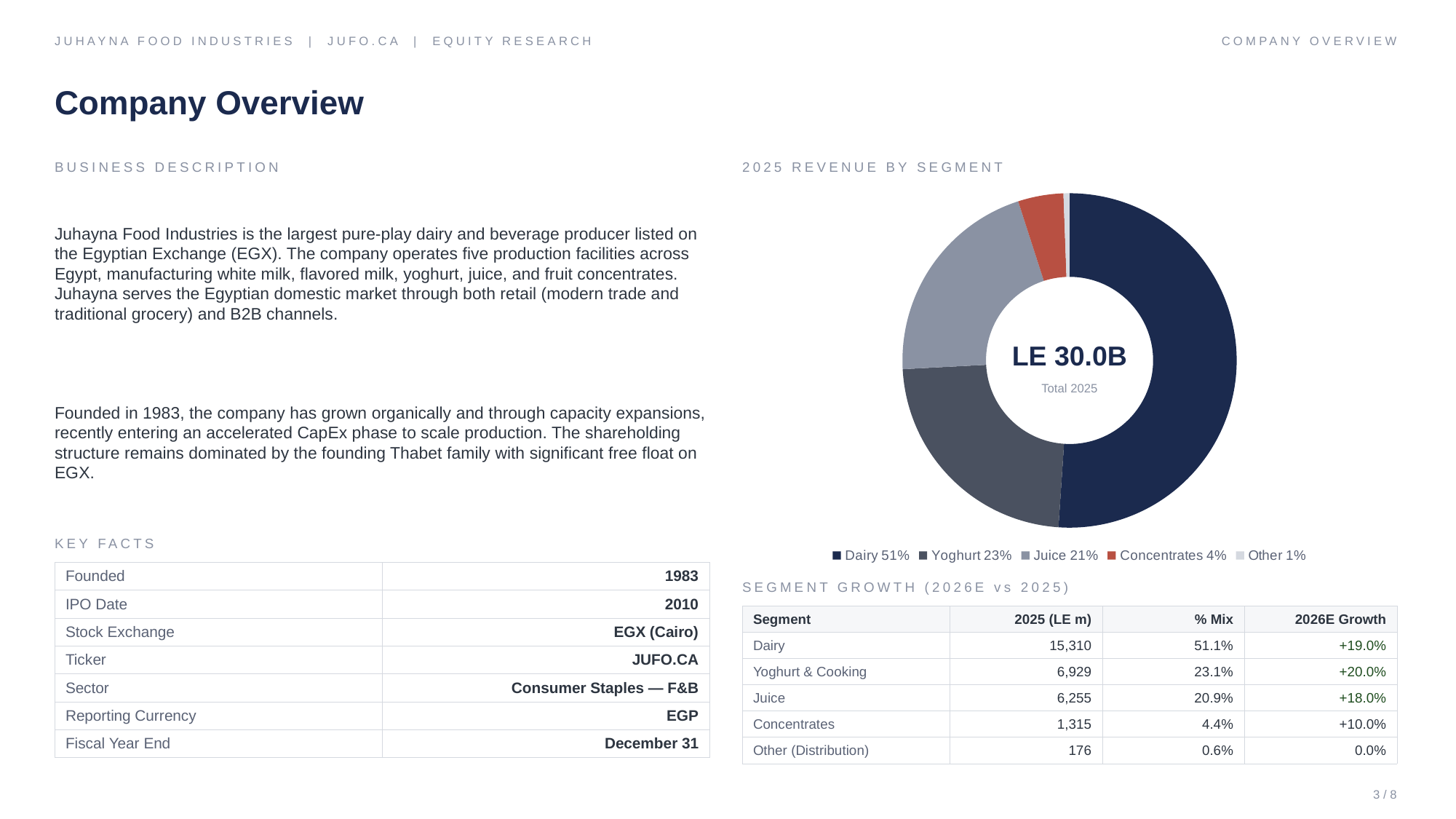
In the 2025 revenue by segment chart, which has a larger share: Yoghurt or Juice? Yoghurt How many segments are shown in the 2025 revenue by segment pie chart? 5 In the 2025 revenue by segment chart, what is the difference in percentage points between the Juice and Concentrates shares? 17 percentage points What share of 2025 revenue does the Concentrates segment represent in the pie chart? 4% What kind of chart is used to show 2025 revenue by segment? Pie chart (donut) What share of 2025 revenue does the Dairy segment represent in the pie chart? 51% What is the title of the pie chart on the slide? 2025 Revenue by Segment In the 2025 revenue by segment chart, what is the difference in percentage points between the Dairy and Yoghurt shares? 28 percentage points What share of 2025 revenue does the Juice segment represent in the pie chart? 21% Which segment has the smallest slice in the 2025 revenue by segment chart? Other What total value is printed in the centre of the 2025 revenue by segment donut chart? LE 30.0B Which segment has the largest slice in the 2025 revenue by segment chart? Dairy